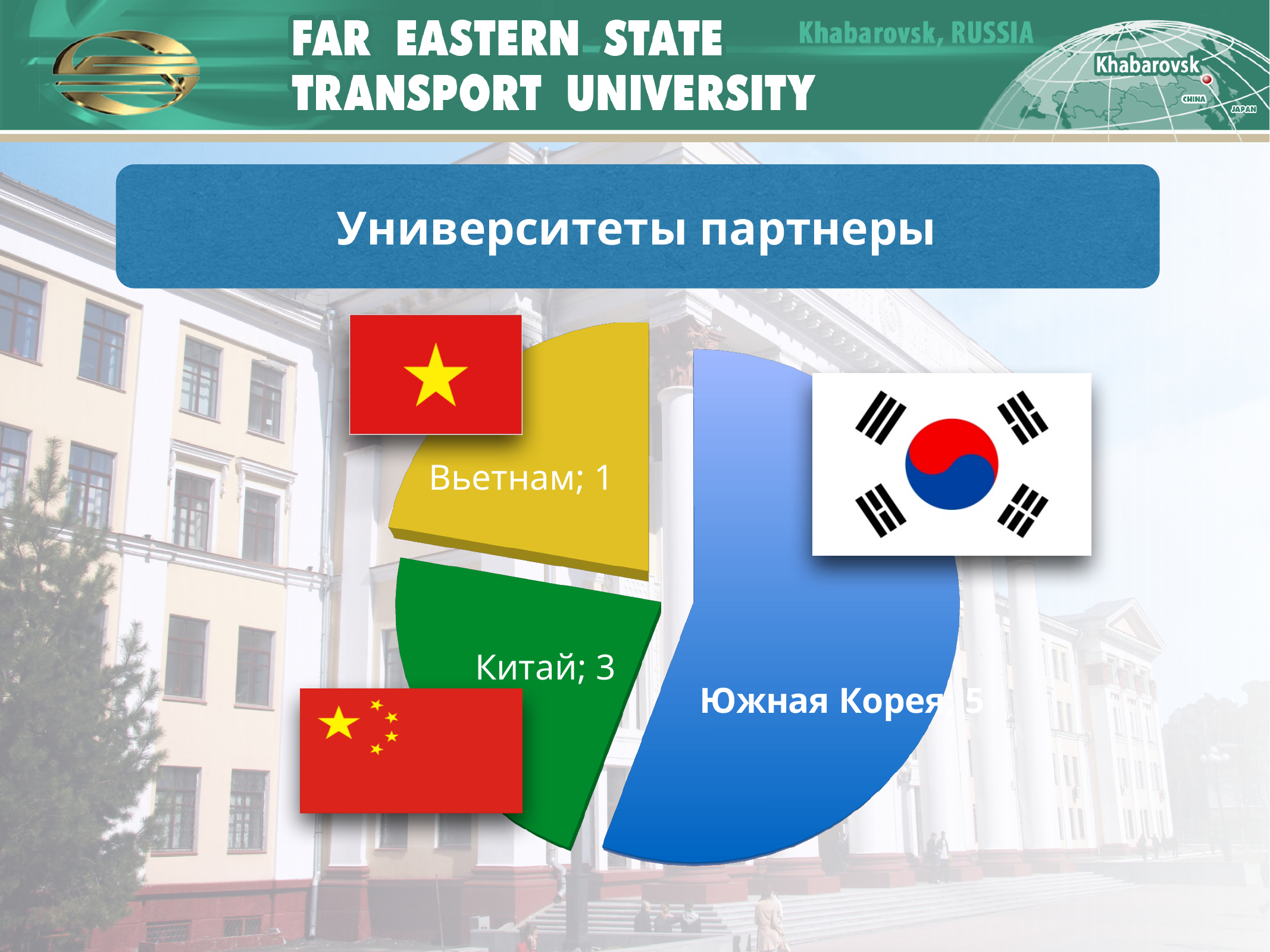
What is the difference between the values for Китай and Вьетнам? 2 What is the value shown for Вьетнам in the pie chart? 1 What is the title shown above the chart? Университеты партнеры What is the total of all the values shown in the pie chart? 9 What is the value shown for Южная Корея in the pie chart? 5 Which category has the largest slice in the pie chart? Южная Корея What is the value shown for Китай in the pie chart? 3 What kind of chart is shown on the slide? pie chart How many categories (slices) does the pie chart have? 3 Which has a larger value, Китай or Вьетнам? Китай What is the difference between the values for Южная Корея and Китай? 2